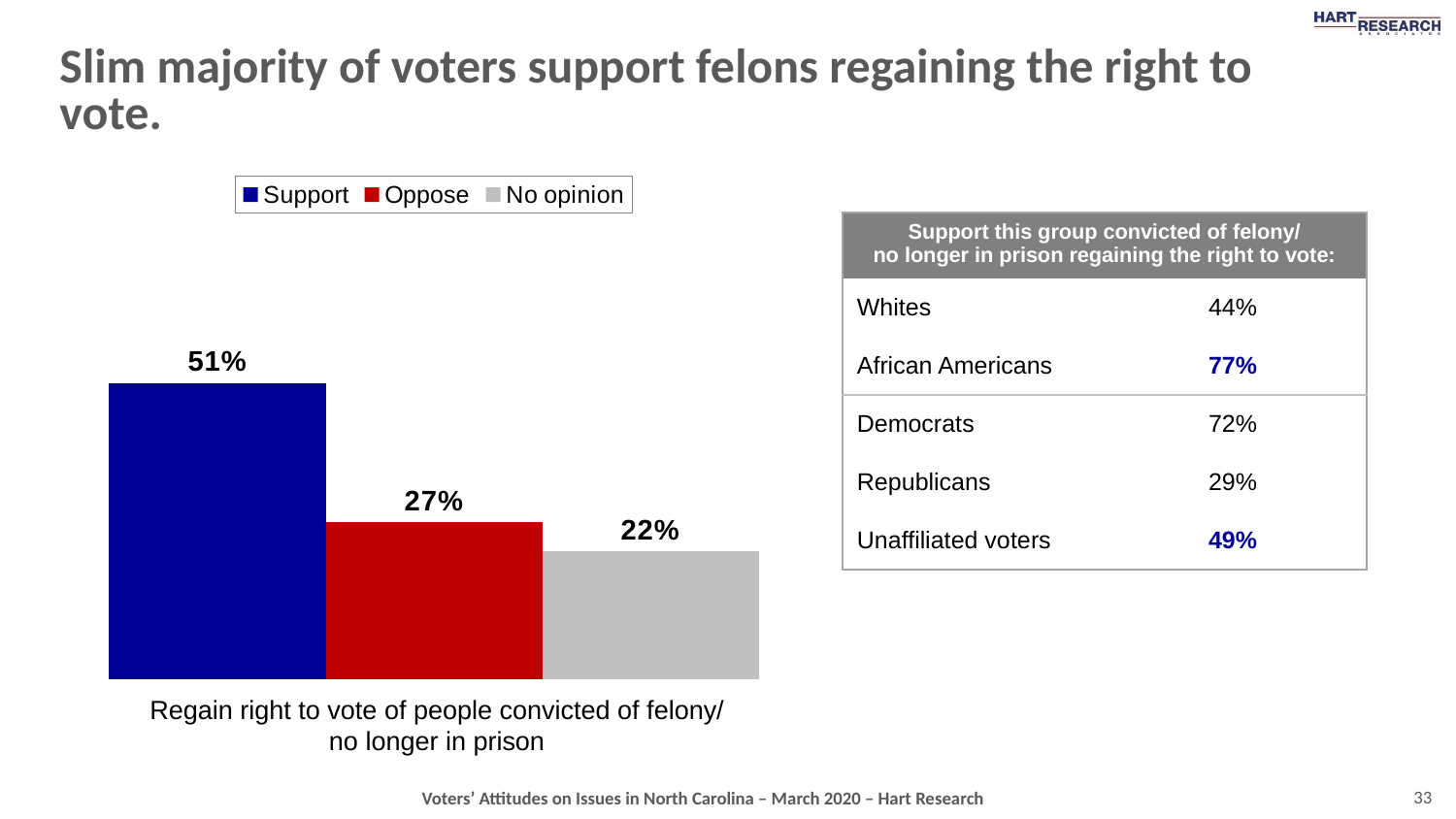
What colour is the Support bar? Blue What percentage of voters support people convicted of a felony and no longer in prison regaining the right to vote? 51% How many series does the legend list? 3 What is the difference between the Oppose and No opinion percentages? 5 percentage points What is the category label beneath the bars? Regain right to vote of people convicted of felony/ no longer in prison Which is larger, the Support percentage or the Oppose percentage? Support What percentage of voters have no opinion on felons regaining the right to vote? 22% Which response has the highest value in the bar chart? Support What kind of chart is shown on the slide? Bar chart What is the difference between the Support and Oppose percentages? 24 percentage points What percentage of voters oppose felons regaining the right to vote? 27% Which response has the lowest value in the bar chart? No opinion